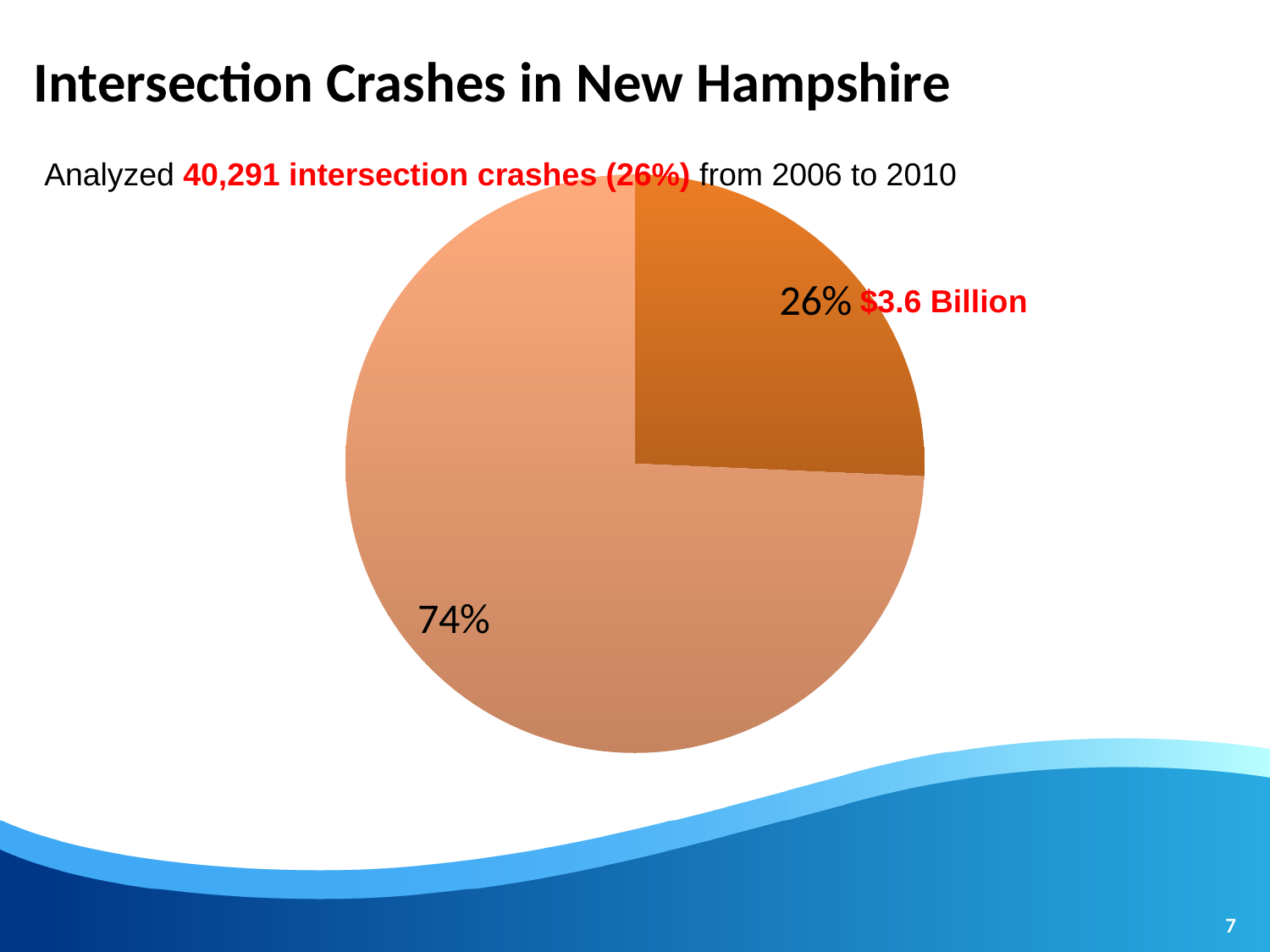
How many slices does the pie chart have? 2 Which slice of the pie chart is the smallest? 26% What share of the pie does the darker orange slice represent? 26% What dollar amount is printed next to the 26% slice? $3.6 Billion What is the difference in percentage points between the two slices of the pie chart? 48 What percentage is shown on the smaller, darker orange slice of the pie chart? 26% What is the title of the slide containing the pie chart? Intersection Crashes in New Hampshire What kind of chart is shown on the slide? pie chart Which slice of the pie chart is the largest? 74% Is the share of the lighter slice greater or less than 50%? greater Is the darker orange slice larger or smaller than the lighter slice? smaller What percentage is shown on the larger slice of the pie chart? 74%